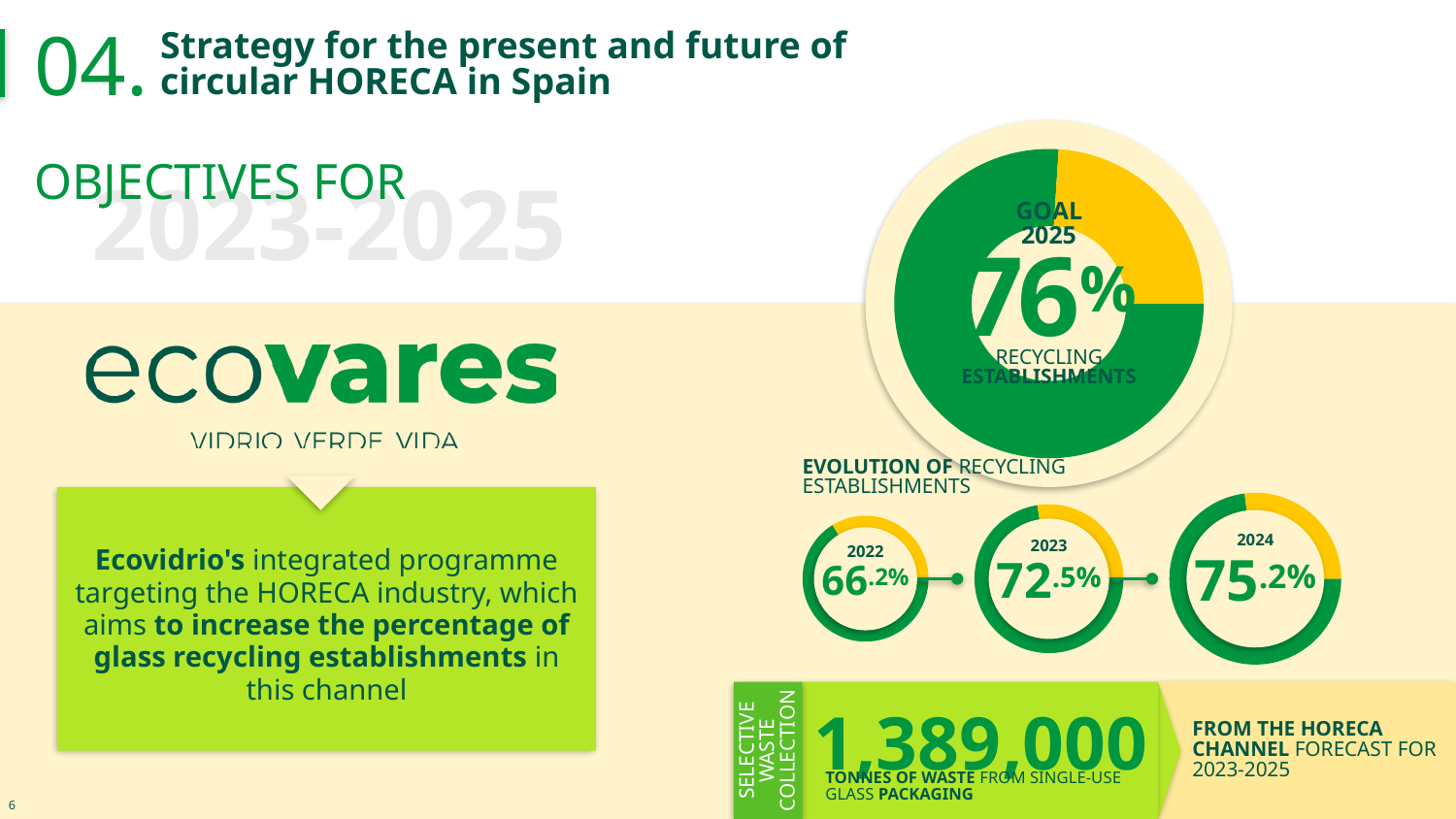
How many yearly donut charts are shown under 'Evolution of recycling establishments'? 3 In the 'Evolution of recycling establishments' charts, what is the value for 2024? 75.2% In the 'Evolution of recycling establishments' charts, is the value for 2023 larger or smaller than the value for 2024? smaller In the 'Evolution of recycling establishments' charts, what is the value for 2023? 72.5% What kind of chart is used to show the 'Goal 2025' figure of 76%? donut (pie) chart In the 'Evolution of recycling establishments' charts, what is the difference between the 2023 and 2022 values? 6.3 percentage points In the 'Evolution of recycling establishments' charts, what is the value for 2022? 66.2% In the 'Goal 2025' chart, what percentage of recycling establishments is the goal? 76% Do the values in the 'Evolution of recycling establishments' charts rise or fall from 2022 to 2024? rise In the 'Evolution of recycling establishments' charts, which year has the highest value? 2024 In the 'Evolution of recycling establishments' charts, what is the difference between the 2024 and 2022 values? 9 percentage points In the 'Evolution of recycling establishments' charts, which year has the lowest value? 2022